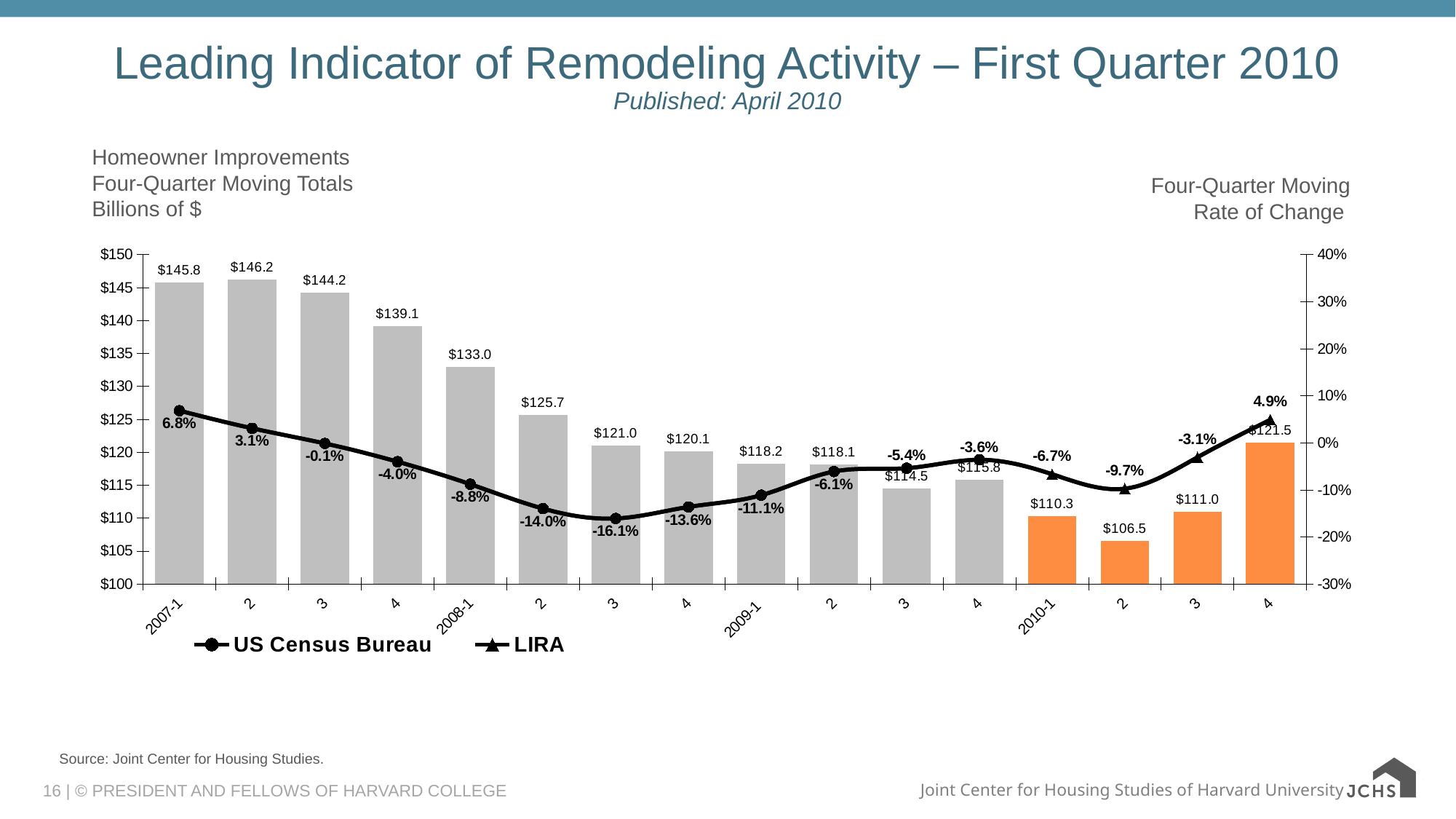
What kind of chart is used for the homeowner improvements totals? Bar chart How many series does the legend list? 2 What is the homeowner improvements four-quarter moving total for 2007-1? $145.8 Which is larger, the homeowner improvements total for 2009-3 or for 2009-4? 2009-4 What is the difference between the homeowner improvements totals for 2007-1 and 2010-2? $39.3 What is the four-quarter moving rate of change shown for 2008-3? -16.1% Which quarter has the lowest four-quarter moving rate of change on the line? 2008-3 How many bars (quarters) are plotted in the chart? 16 What are the two series named in the legend? US Census Bureau and LIRA Which quarter has the highest homeowner improvements four-quarter moving total? 2007-2 What is the homeowner improvements value shown for the last bar, 2010-4? $121.5 Which quarter has the lowest homeowner improvements four-quarter moving total? 2010-2